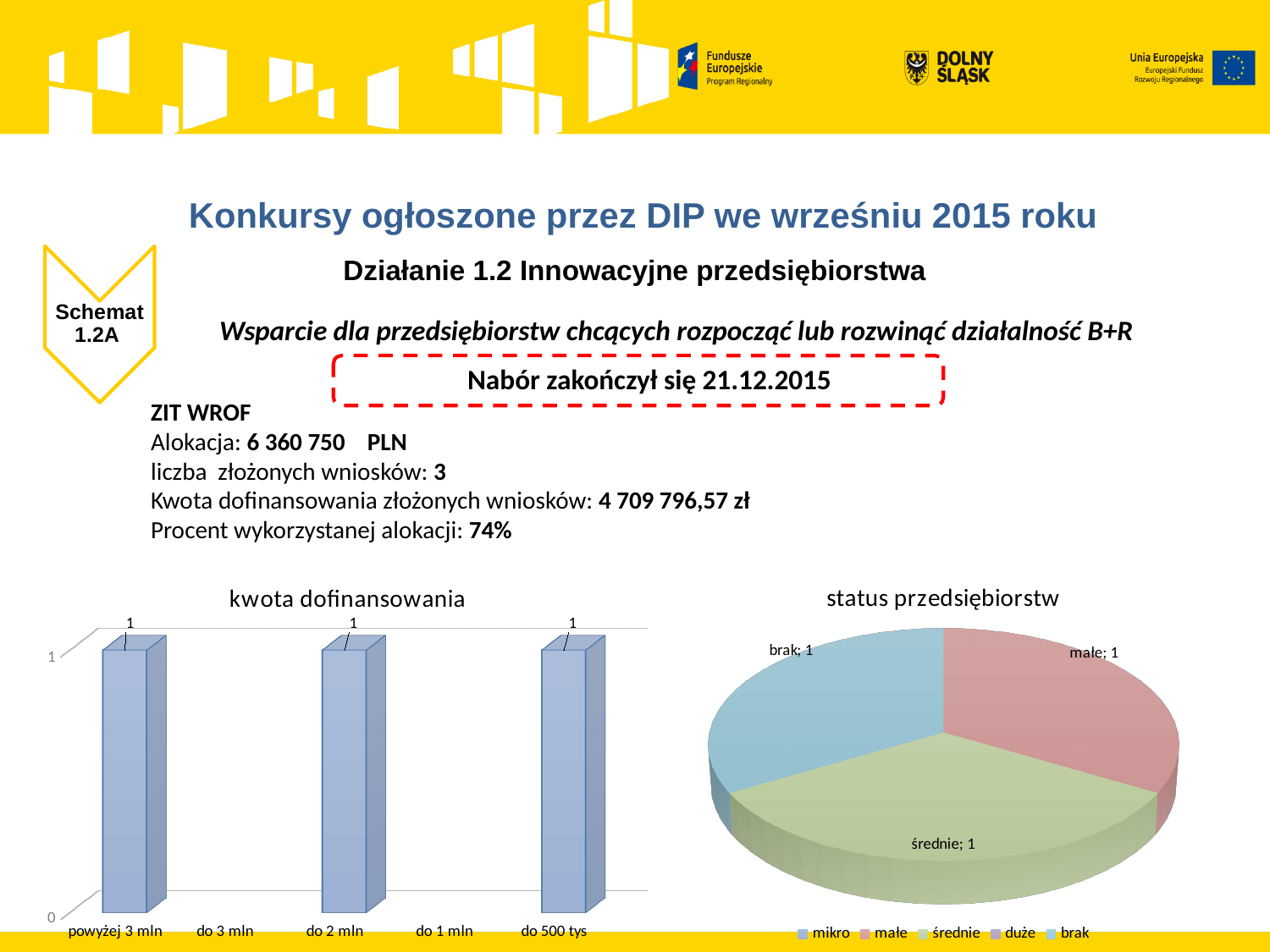
In the 'kwota dofinansowania' chart, what is the value for 'do 500 tys'? 1 How many entries does the legend of the 'status przedsiębiorstw' chart list? 5 In the 'kwota dofinansowania' chart, how many categories are shown on the x axis? 5 What kind of chart is the 'status przedsiębiorstw' chart? pie chart In the 'kwota dofinansowania' chart, how many bars are visible? 3 In the 'kwota dofinansowania' chart, what is the value for 'powyżej 3 mln'? 1 In the 'status przedsiębiorstw' chart, what is the value for 'średnie'? 1 What kind of chart is the 'kwota dofinansowania' chart? bar chart In the 'status przedsiębiorstw' chart, what is the value for 'brak'? 1 In the 'status przedsiębiorstw' chart, what is the value for 'małe'? 1 In the 'status przedsiębiorstw' chart, how many slices are shown in the pie? 3 What is the title of the chart on the right side of the slide? status przedsiębiorstw